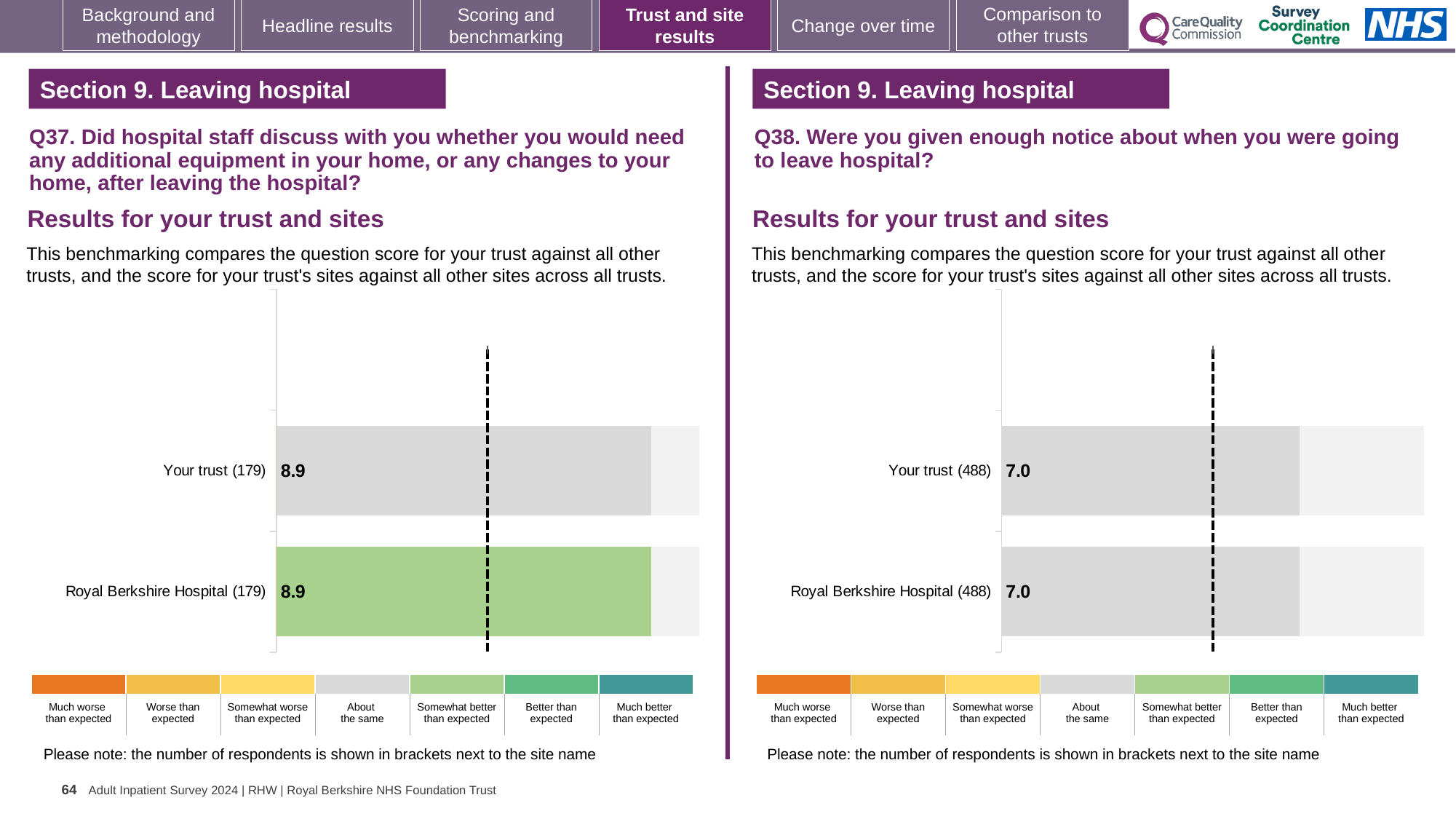
On the Q37 chart (left), what is the score for Your trust? 8.9 What type of chart is used on the Q37 chart (left)? Bar chart On the Q37 chart (left), what is the score for Royal Berkshire Hospital? 8.9 On the Q38 chart (right), what is the score for Royal Berkshire Hospital? 7.0 On the Q38 chart (right), how many bars are plotted? 2 On the Q37 chart (left), what is the difference between the score for Your trust and the score for Royal Berkshire Hospital? 0.0 On the Q38 chart (right), how many respondents are shown in brackets for Your trust? 488 On the Q37 chart (left), which benchmark category does the colour of the Royal Berkshire Hospital bar correspond to? Somewhat better than expected On the Q38 chart (right), which benchmark category does the colour of the Royal Berkshire Hospital bar correspond to? About the same On the Q37 chart (left), how many respondents are shown in brackets for Royal Berkshire Hospital? 179 Is the score for Your trust higher on the Q37 chart (left) or on the Q38 chart (right)? Q37 chart (left) On the Q38 chart (right), what is the score for Your trust? 7.0